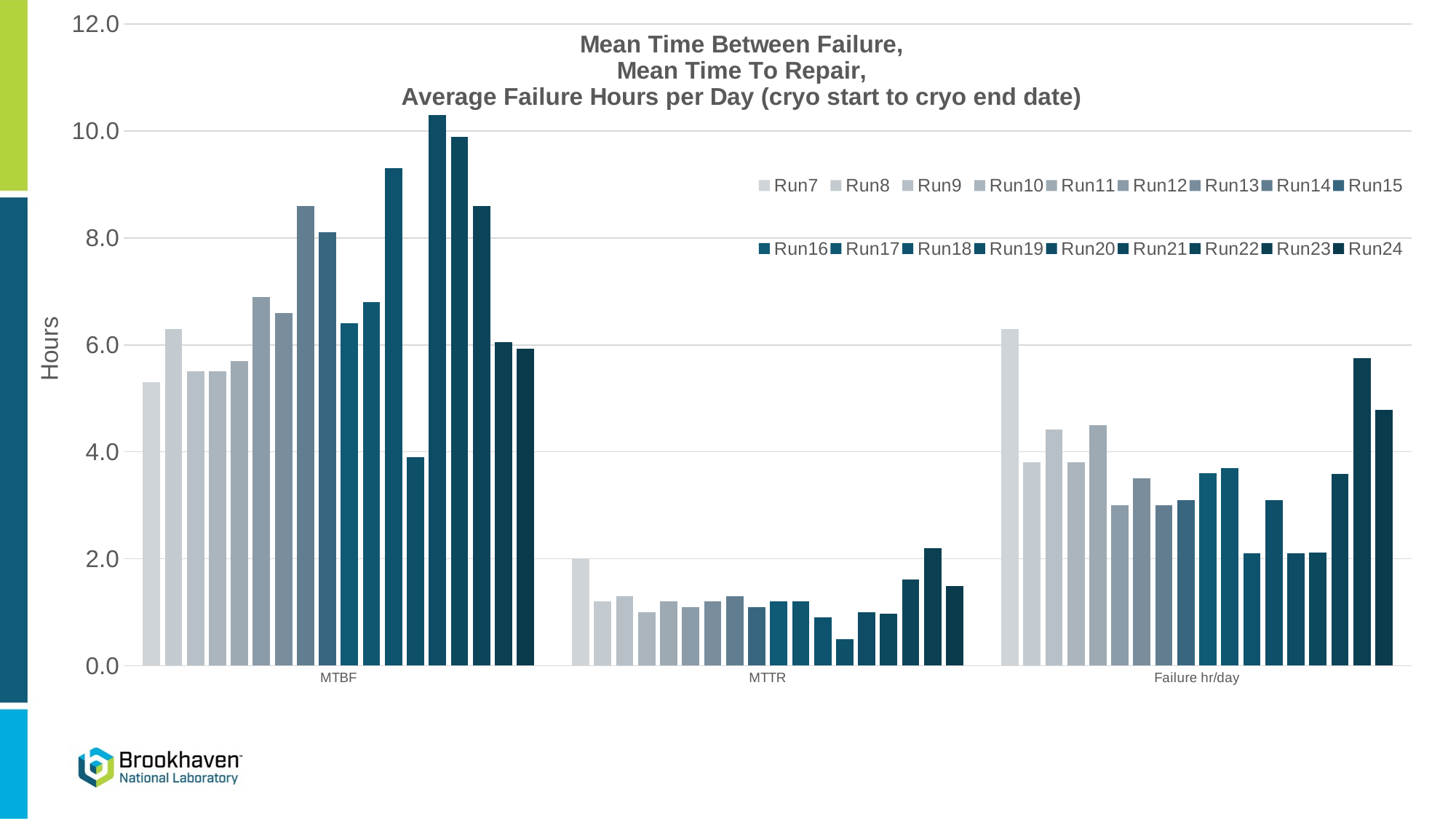
What is the label of the y axis? Hours How many categories are shown on the x axis? 3 For MTBF, which is larger, Run7 or Run8? Run8 Which run has the lowest MTTR value? Run19 What are the three categories on the x axis? MTBF, MTTR, Failure hr/day Is the MTBF value for Run20 greater or less than 10.0? greater Which run has the highest Failure hr/day value? Run7 Is the MTTR value for Run19 greater or less than 1.0? less What kind of chart is shown on the slide? Bar chart Which run has the highest MTBF value? Run20 How many series does the legend list? 18 Is the MTBF value for Run7 greater or less than 4.0? greater